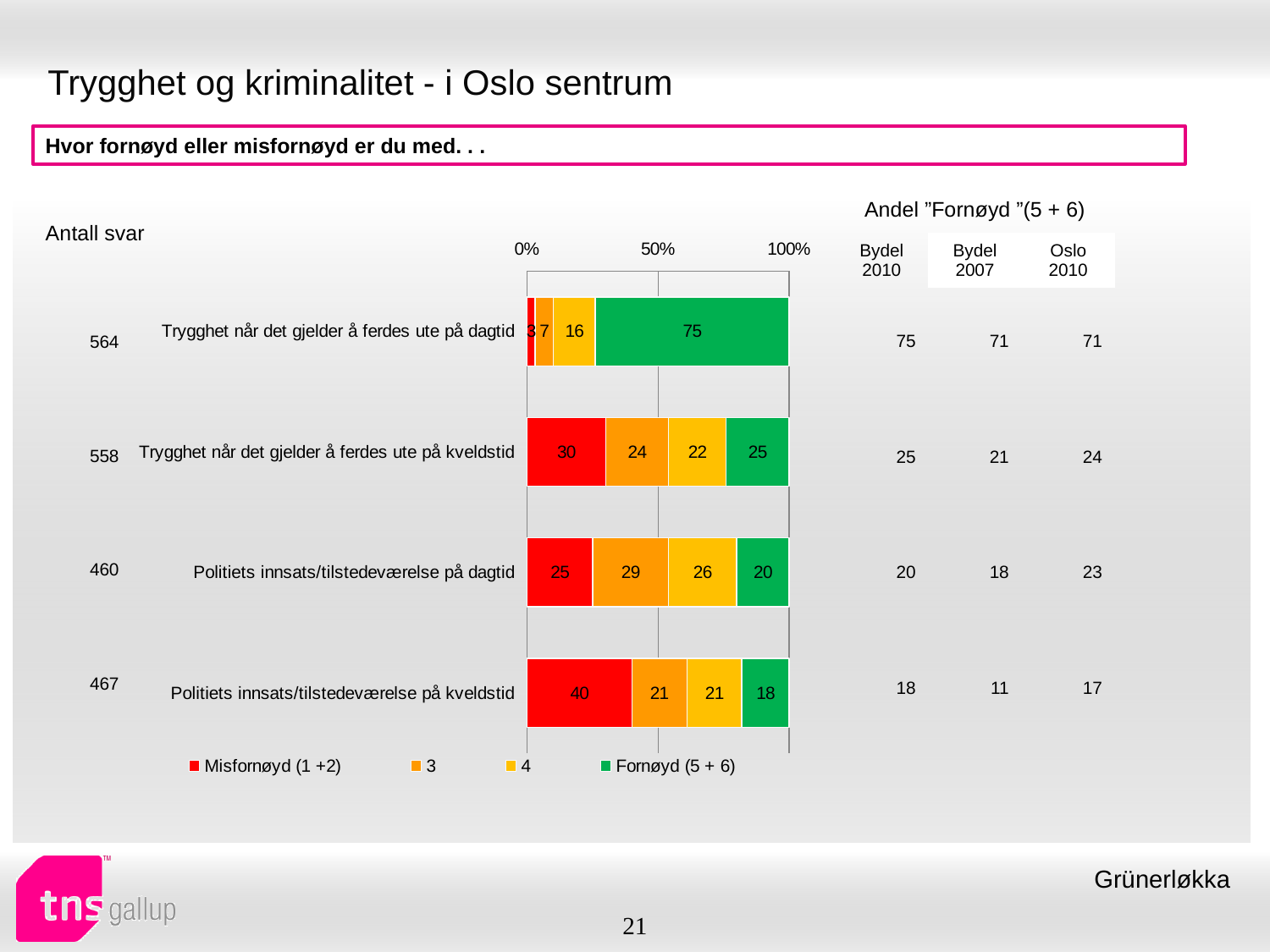
Which category has the highest 'Fornøyd (5 + 6)' value? Trygghet når det gjelder å ferdes ute på dagtid What kind of chart is shown on the slide? stacked bar chart What is the difference between the 'Misfornøyd (1 +2)' values for 'Politiets innsats/tilstedeværelse på kveldstid' and 'Trygghet når det gjelder å ferdes ute på kveldstid'? 10 What is the 'Misfornøyd (1 +2)' value for 'Politiets innsats/tilstedeværelse på kveldstid'? 40 What is the 'Fornøyd (5 + 6)' value for 'Trygghet når det gjelder å ferdes ute på dagtid'? 75 What is the value of series '4' for 'Trygghet når det gjelder å ferdes ute på kveldstid'? 22 Which is larger: the 'Fornøyd (5 + 6)' value for 'Trygghet når det gjelder å ferdes ute på kveldstid' or for 'Politiets innsats/tilstedeværelse på dagtid'? Trygghet når det gjelder å ferdes ute på kveldstid Which colour represents the 'Fornøyd (5 + 6)' series in the bar chart? green What is the value of series '3' for 'Politiets innsats/tilstedeværelse på dagtid'? 29 How many categories (statements) are plotted in the bar chart? 4 Which category has the lowest 'Misfornøyd (1 +2)' value? Trygghet når det gjelder å ferdes ute på dagtid How many series does the legend of the bar chart list? 4